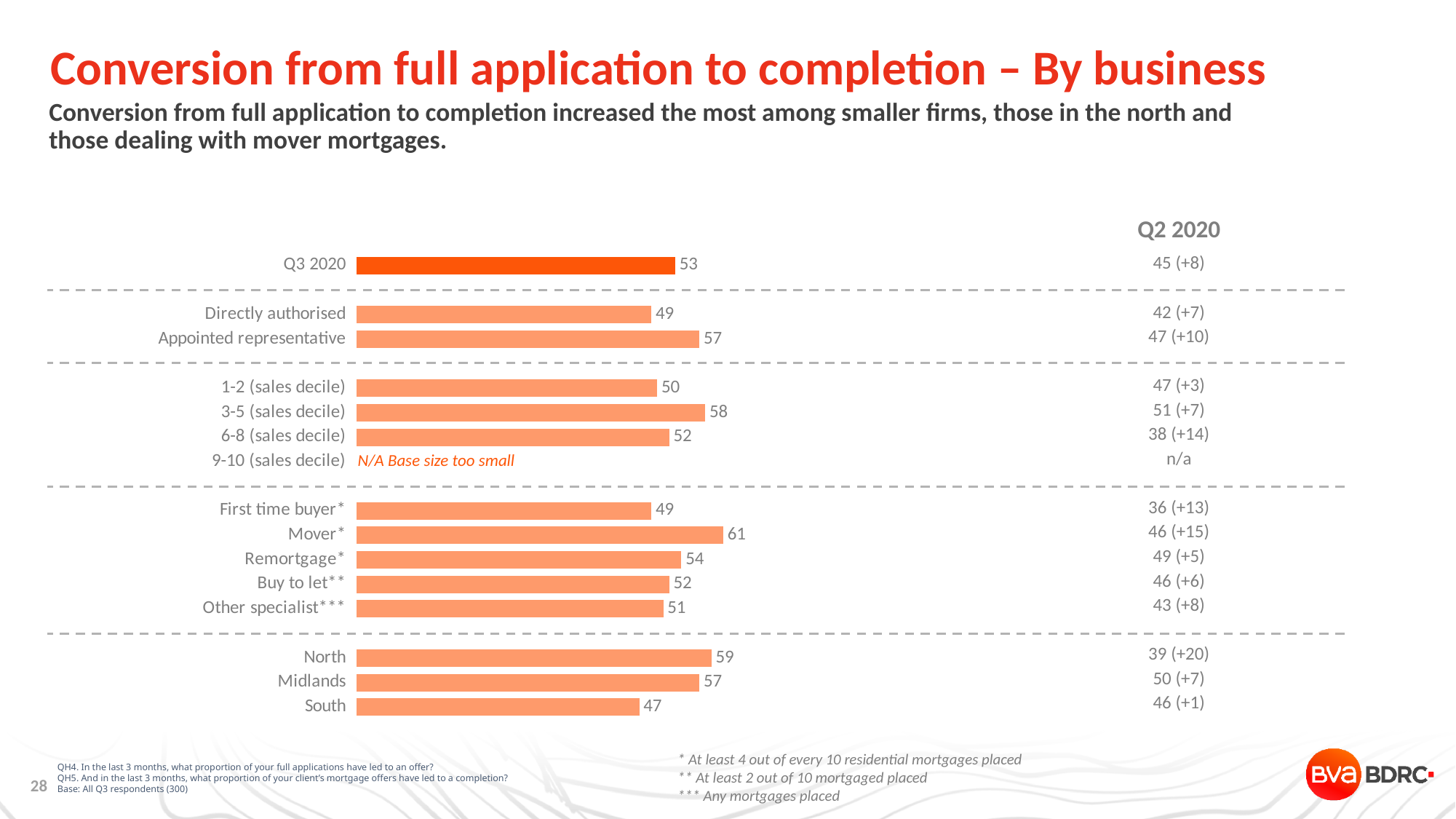
What is the difference between the Q3 2020 values for 3-5 (sales decile) and 1-2 (sales decile)? 8 What is the Q2 2020 value shown for North? 39 (+20) Which category has the lowest plotted Q3 2020 value? South What is the Q3 2020 value for Mover? 61 What is the difference between the Q3 2020 values for North and South? 12 What is the overall Q3 2020 value shown at the top of the chart? 53 What kind of chart is shown on the slide? Bar chart Which has a higher Q3 2020 value, Directly authorised or Appointed representative? Appointed representative Which category has the highest Q3 2020 value? Mover What is the Q3 2020 value for Appointed representative? 57 Which category is marked 'N/A Base size too small'? 9-10 (sales decile) What is the Q3 2020 value for South? 47